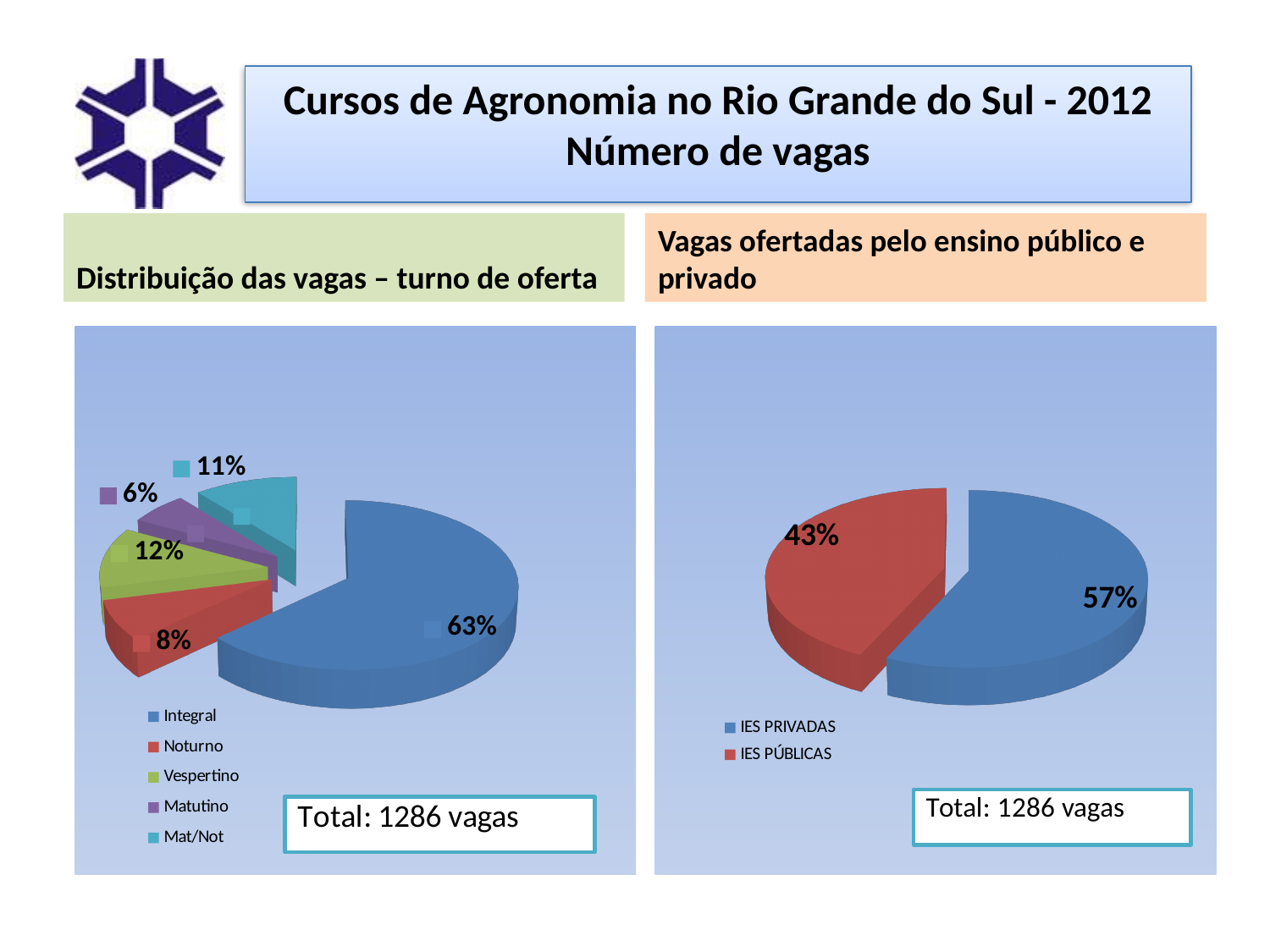
In the left chart (Distribuição das vagas – turno de oferta), what share of vagas is Mat/Not? 11% In the left chart (Distribuição das vagas – turno de oferta), which category has the smallest share? Matutino In the left chart (Distribuição das vagas – turno de oferta), what share of vagas is Vespertino? 12% In the left chart (Distribuição das vagas – turno de oferta), what share of vagas is Integral? 63% In the left chart (Distribuição das vagas – turno de oferta), which is larger, Noturno or Mat/Not? Mat/Not What type of chart is the right chart (Vagas ofertadas pelo ensino público e privado)? Pie chart In the left chart (Distribuição das vagas – turno de oferta), how many categories does the legend list? 5 In the right chart (Vagas ofertadas pelo ensino público e privado), what is the difference in percentage points between IES PRIVADAS and IES PÚBLICAS? 14 percentage points In the left chart (Distribuição das vagas – turno de oferta), what is the difference in percentage points between Vespertino and Noturno? 4 percentage points In the right chart (Vagas ofertadas pelo ensino público e privado), what share of vagas is IES PÚBLICAS? 43% In the right chart (Vagas ofertadas pelo ensino público e privado), which category has the larger share? IES PRIVADAS In the left chart (Distribuição das vagas – turno de oferta), which category has the largest share? Integral